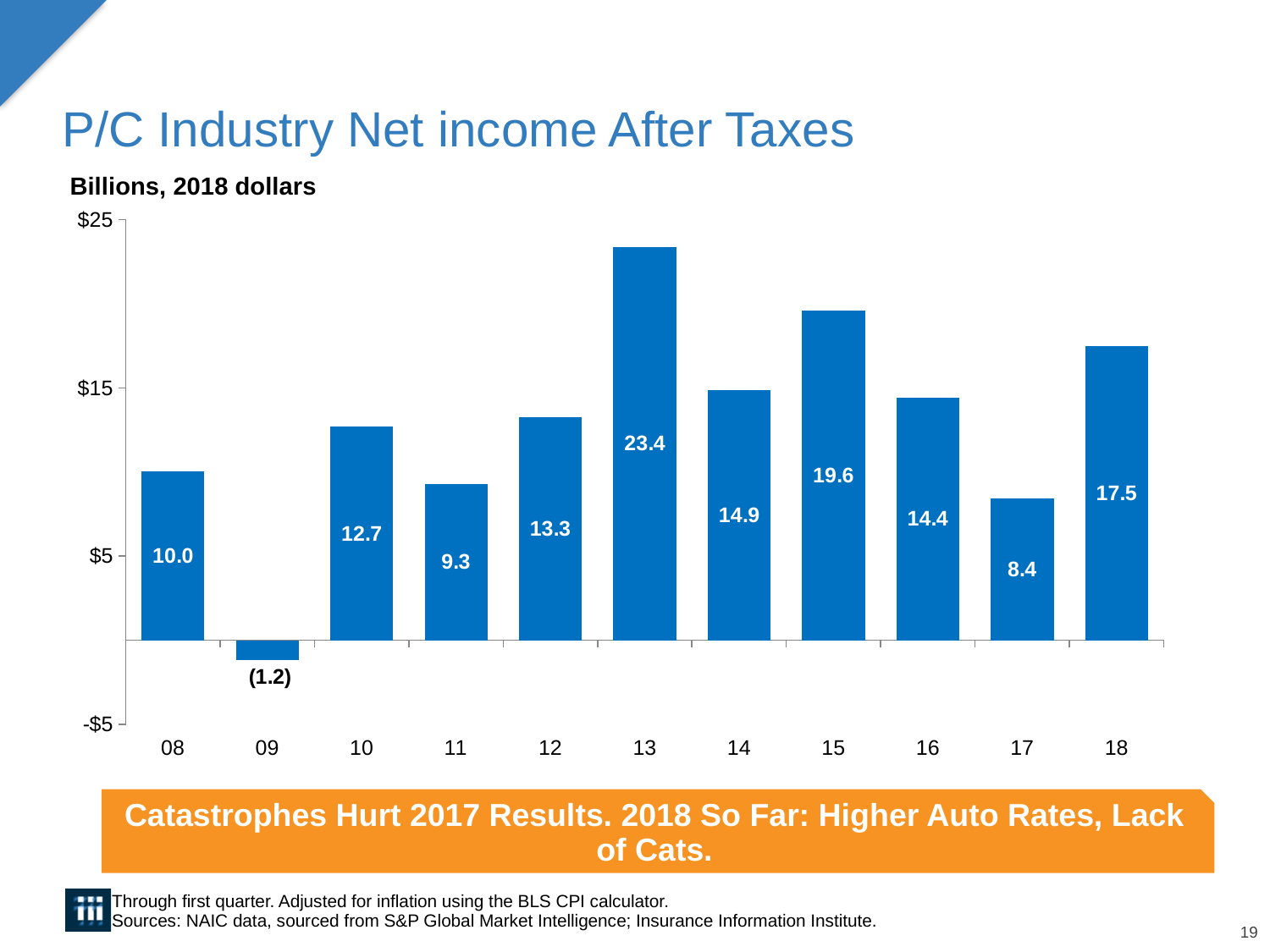
What is the value for 17? 8.4 What kind of chart is this? bar chart Which year has the highest value? 13 What is the value for 09? (1.2) Which is larger, the value for 10 or the value for 11? 10 How many years are shown on the x axis? 11 Which year has the lowest value? 09 What is the value for 13? 23.4 Is the value for 18 greater or less than $15? greater Do the values rise or fall from 16 to 17? fall What is the title of the chart? P/C Industry Net income After Taxes What is the difference between the values for 15 and 14? 4.7